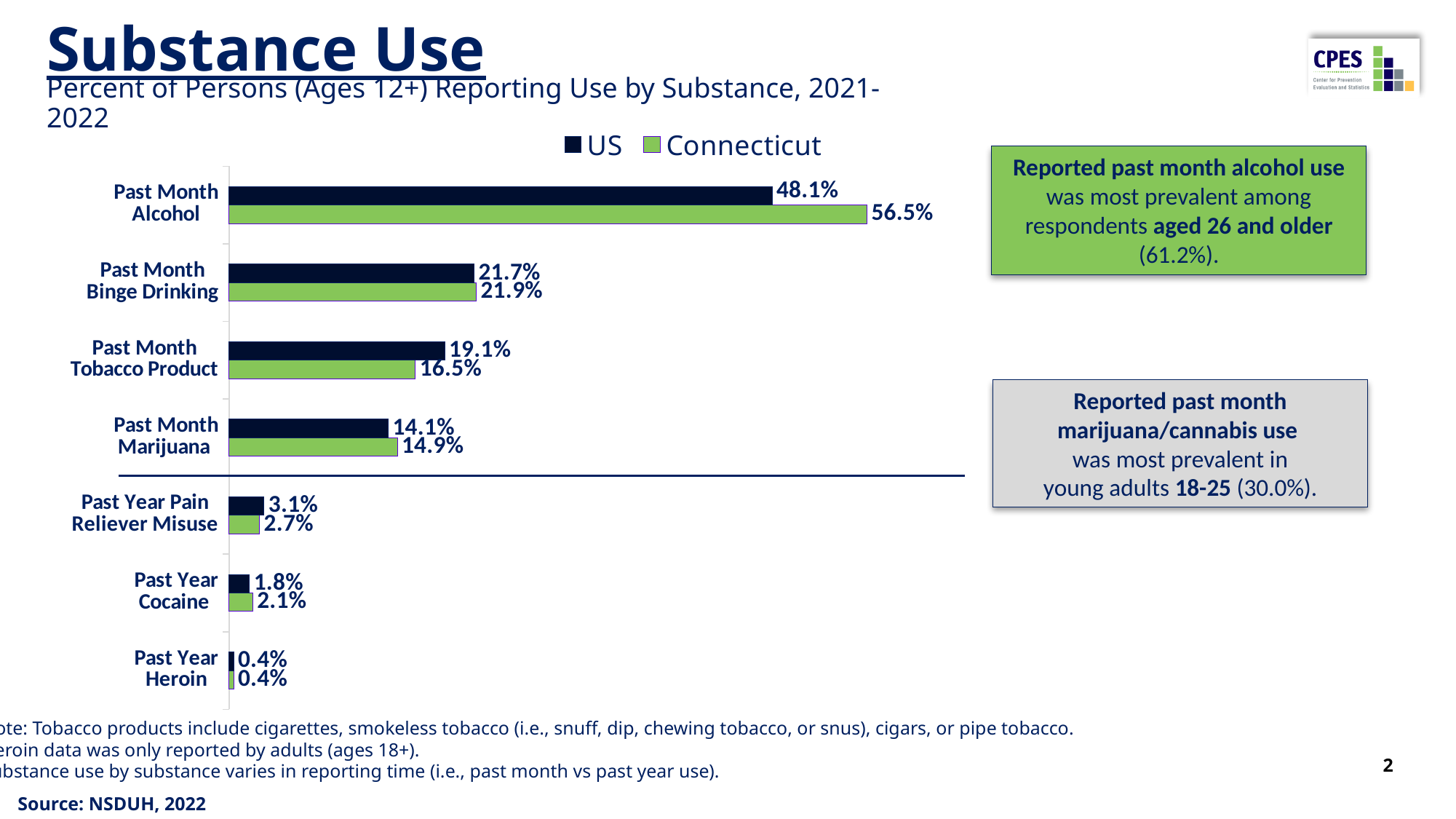
Which substance category has the lowest US value? Past Year Heroin What is the difference between the US and Connecticut values for past month tobacco product use? 2.6% For past year pain reliever misuse, which is larger: the US value or the Connecticut value? US What percent of persons in Connecticut reported past month alcohol use? 56.5% For past month marijuana use, which is larger: the US value or the Connecticut value? Connecticut What is the US value for past month tobacco product use? 19.1% What type of chart is shown on the slide? Bar chart How many substance categories are shown in the chart? 7 How many series does the legend list? 2 What is the difference between the Connecticut and US values for past month alcohol use? 8.4% Which substance category has the highest Connecticut value? Past Month Alcohol What percent of persons in Connecticut reported past year cocaine use? 2.1%